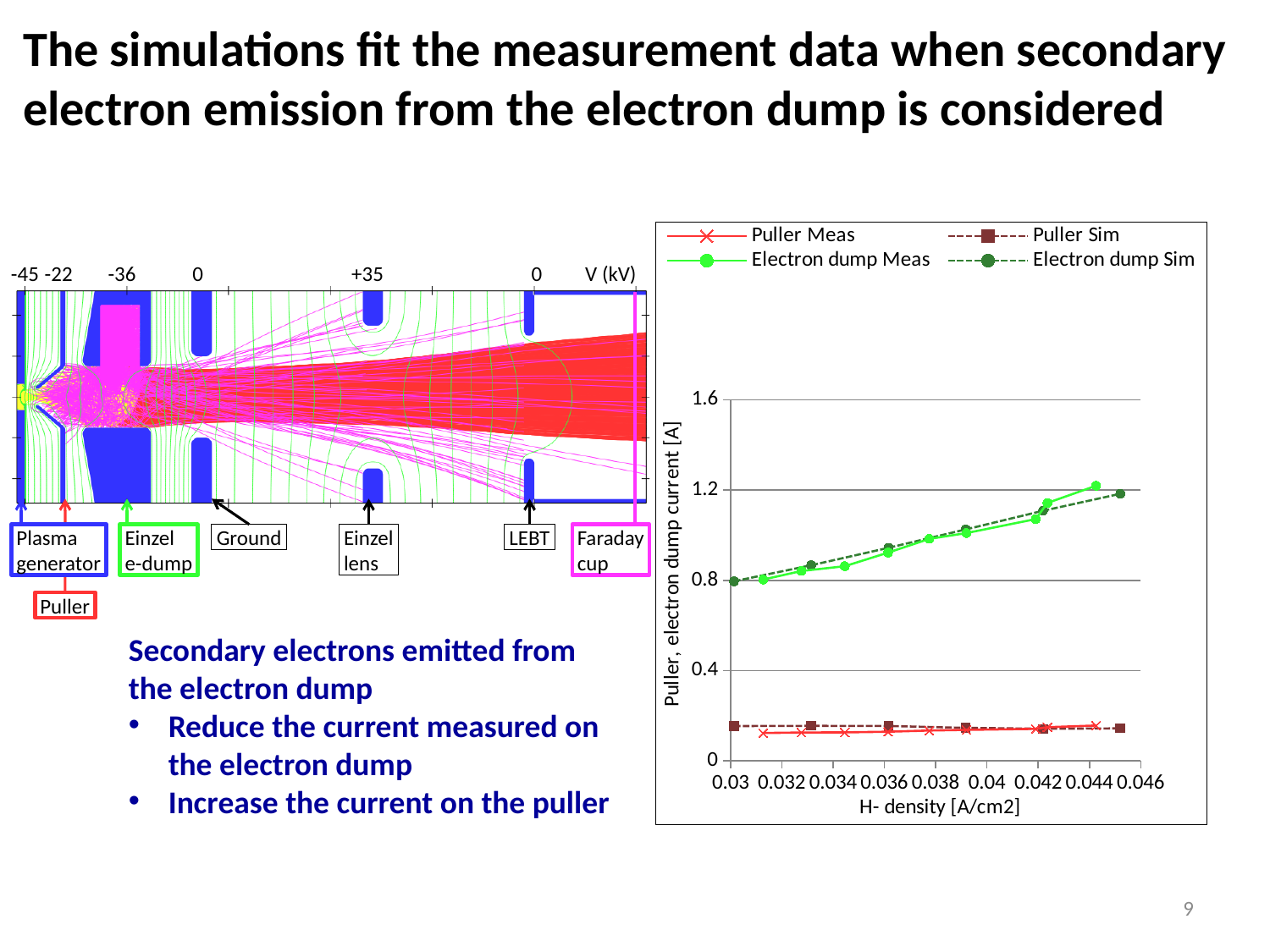
Is the value of Puller Meas at an H- density of 0.036 greater or less than 0.4? less Is the value of Electron dump Sim at an H- density of 0.042 greater or less than 0.8? greater What is the title of the x axis of the chart? H- density [A/cm2] Does the Electron dump Sim series rise or fall as H- density increases? rise Is the value of Electron dump Meas at an H- density of 0.03 greater or less than 1.2? less At an H- density of 0.04, which is larger: Puller Sim or Electron dump Sim? Electron dump Sim How many series does the legend of the chart list? 4 What kind of chart is shown on the right of the slide? line chart Does the Electron dump Meas series rise or fall as H- density increases? rise At an H- density of 0.03, which is larger: Electron dump Meas or Puller Meas? Electron dump Meas What are the four series named in the chart legend? Puller Meas, Puller Sim, Electron dump Meas, Electron dump Sim